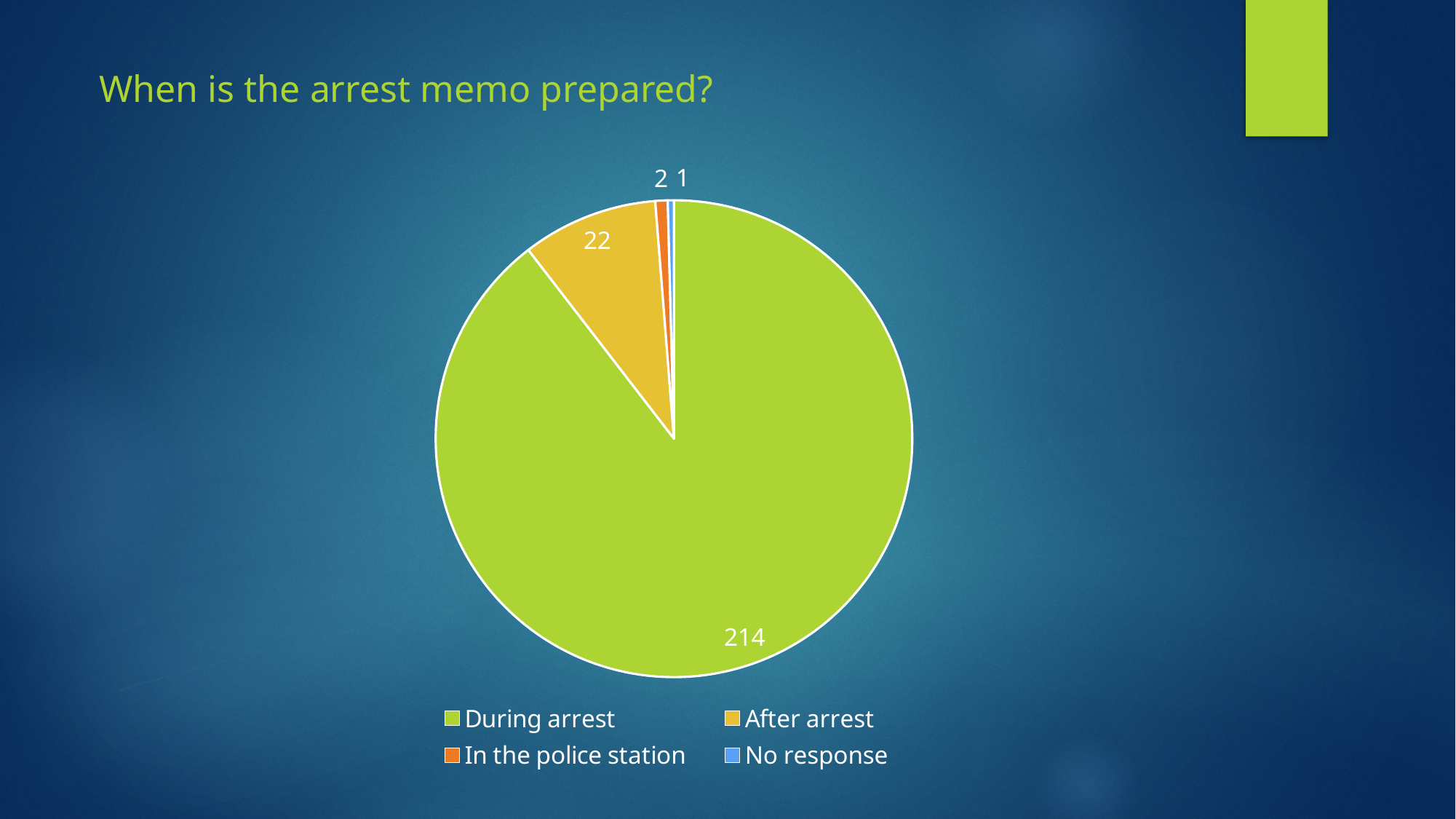
Which category has the largest slice of the pie? During arrest What is the value for "After arrest"? 22 What is the value for "In the police station"? 2 What type of chart is shown on the slide? Pie chart Which is larger, the value for "After arrest" or the value for "In the police station"? After arrest What is the difference between the values for "During arrest" and "After arrest"? 192 What is the title of the chart? When is the arrest memo prepared? How many categories does the pie chart show? 4 What is the value for "During arrest"? 214 What is the value for "No response"? 1 Which category has the smallest slice of the pie? No response What is the total of all four slices in the pie chart? 239